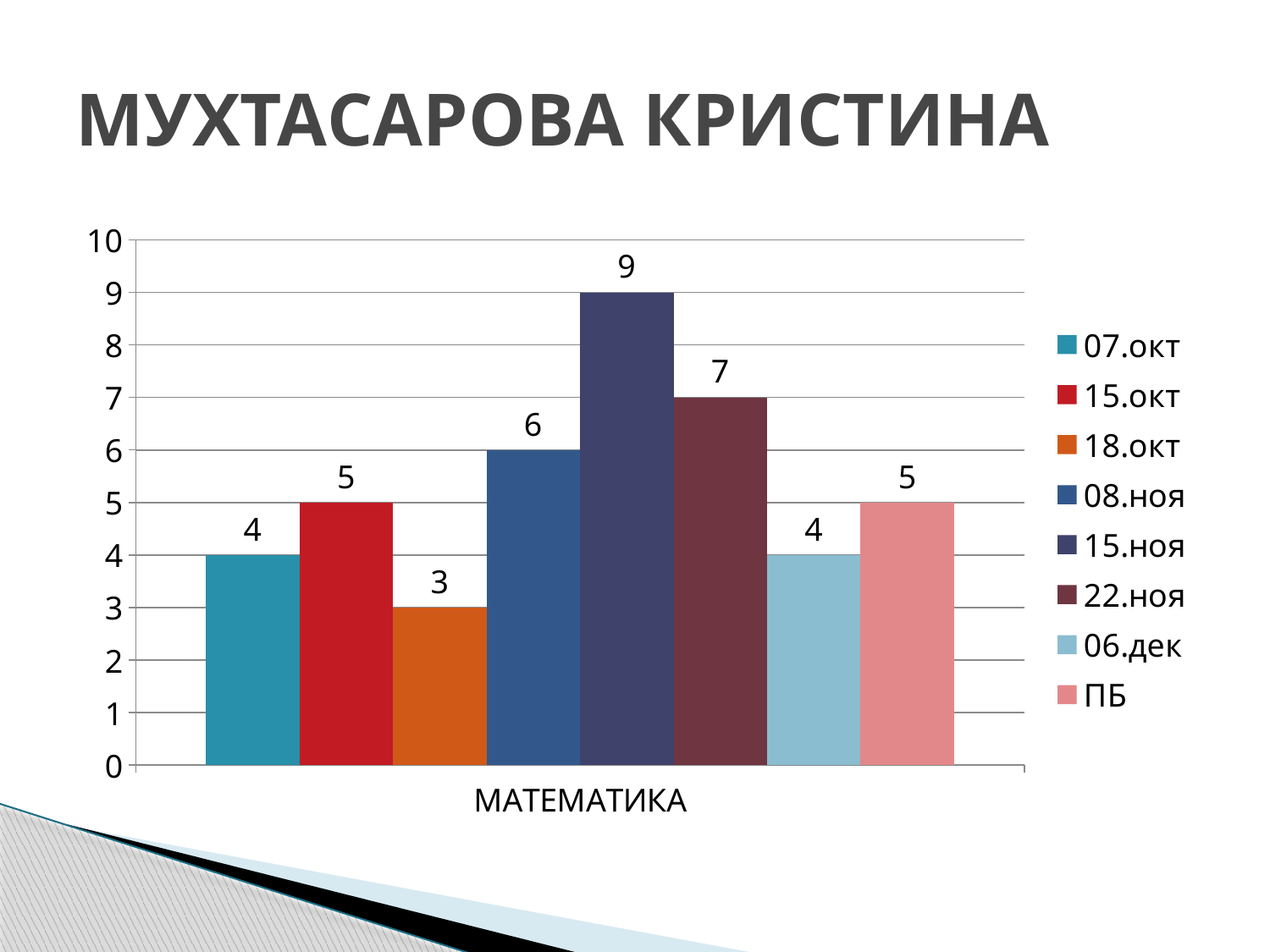
What is the value for the 15.ноя series in the МАТЕМАТИКА chart? 9 Which is larger, the value for 08.ноя or the value for 15.окт? 08.ноя What kind of chart is shown on the slide? bar chart What is the value for the 22.ноя series? 7 What is the category label on the x axis? МАТЕМАТИКА How many series does the legend list? 8 What is the maximum value shown on the y axis? 10 What is the value for the ПБ series? 5 Which series has the lowest value? 18.окт What is the value for the 18.окт series? 3 Which series has the highest value? 15.ноя What is the difference between the 15.ноя value and the 22.ноя value? 2